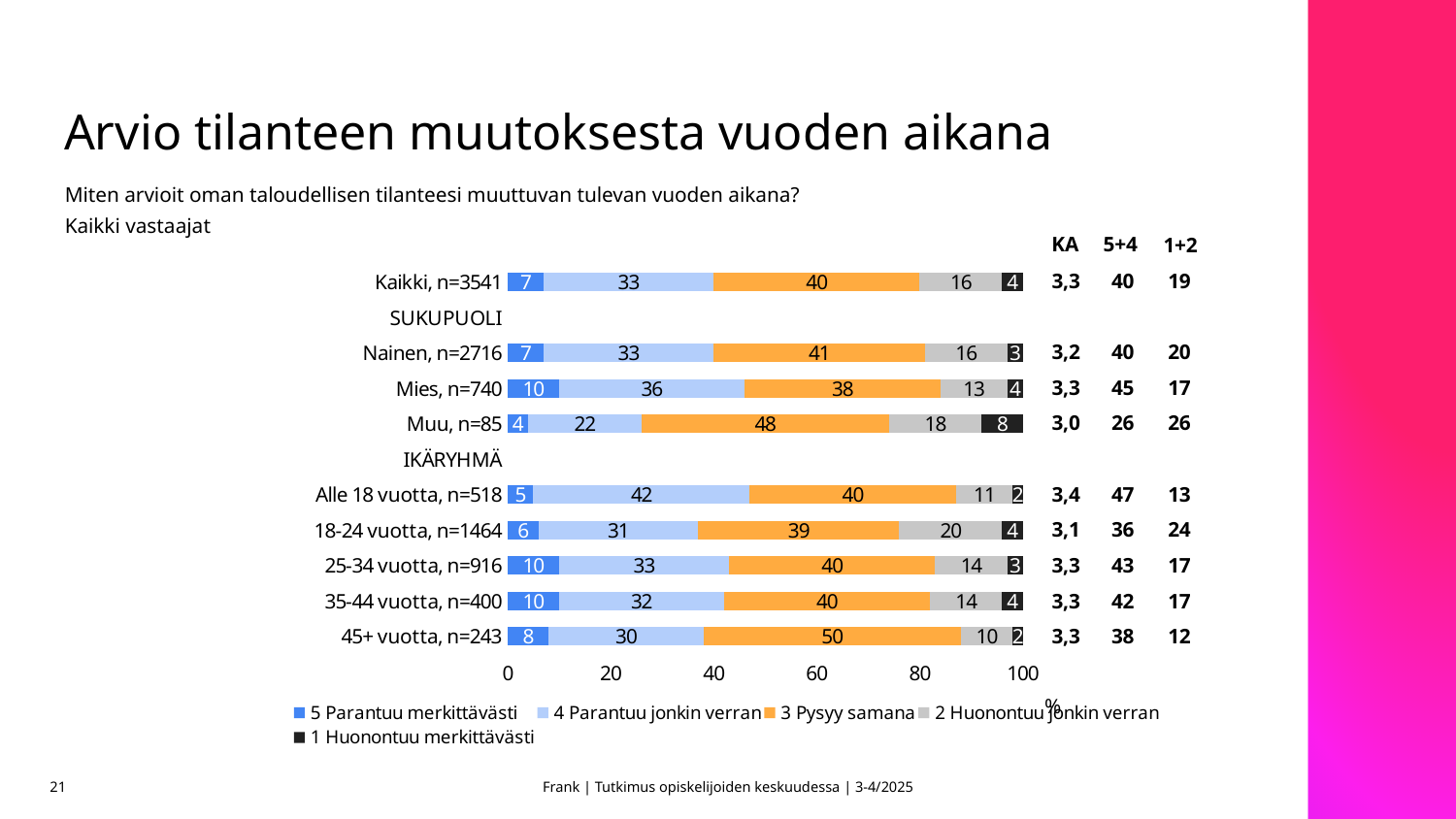
What is the value of "4 Parantuu jonkin verran" for "Alle 18 vuotta, n=518"? 42 How many series does the legend list? 5 Which category has the highest value for "3 Pysyy samana"? 45+ vuotta, n=243 What is the KA value shown for "Alle 18 vuotta, n=518"? 3,4 What is the value of "1 Huonontuu merkittävästi" for "Muu, n=85"? 8 Which is larger: the "3 Pysyy samana" value for "Nainen, n=2716" or for "Mies, n=740"? Nainen, n=2716 What kind of chart is shown on the slide? stacked bar chart What is the value of "5 Parantuu merkittävästi" for "Mies, n=740"? 10 How many category bars are plotted in the chart? 9 What is the value of "3 Pysyy samana" for "45+ vuotta, n=243"? 50 Which category has the lowest value for "4 Parantuu jonkin verran"? Muu, n=85 What is the difference between the "2 Huonontuu jonkin verran" values for "18-24 vuotta, n=1464" and "45+ vuotta, n=243"? 10